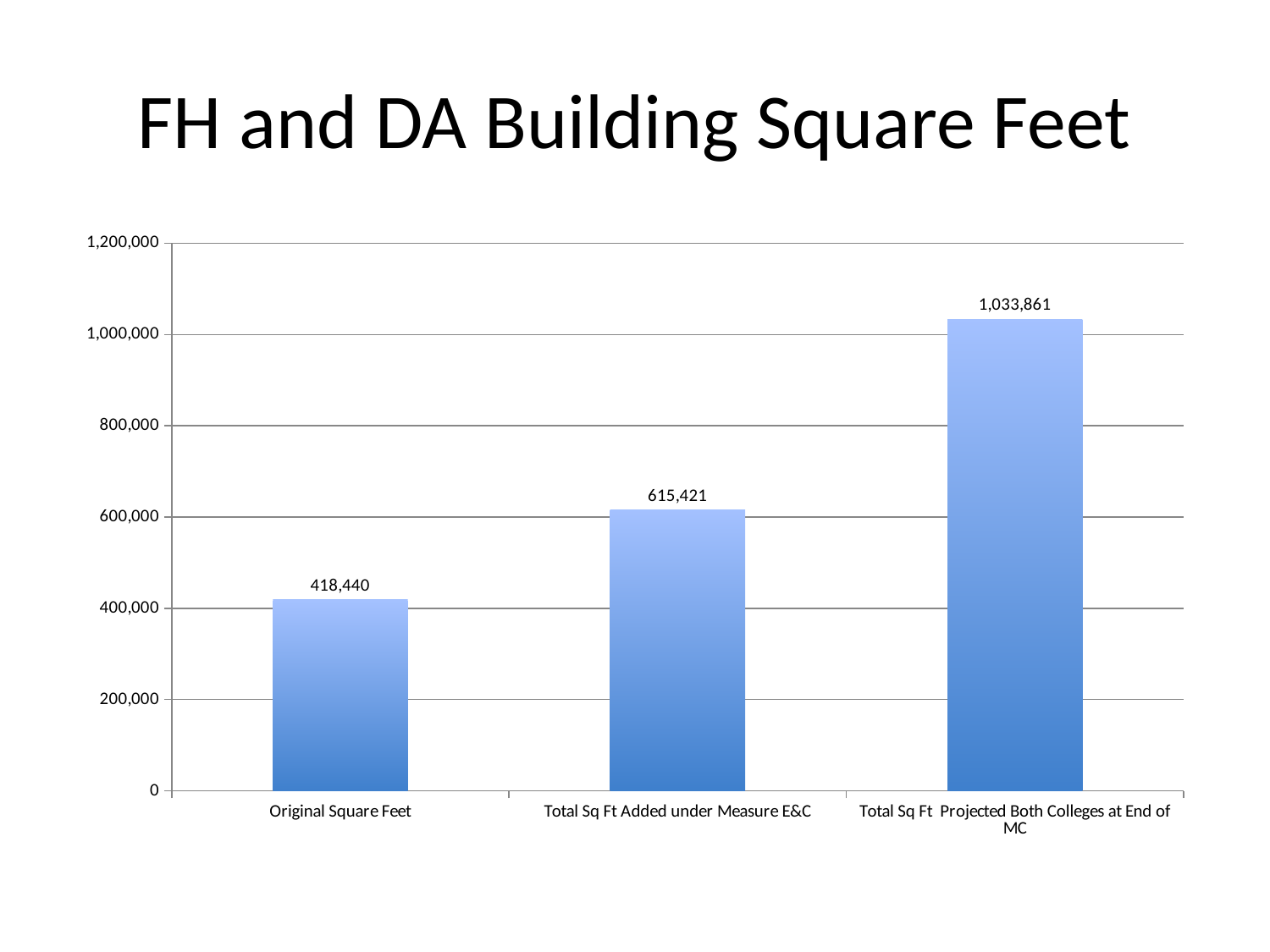
What is the value for Original Square Feet? 418,440 Which category has the lowest value? Original Square Feet What kind of chart is shown on the slide? bar chart What is the value for Total Sq Ft Added under Measure E&C? 615,421 Do the values rise or fall from left to right across the categories? rise Which category has the highest value? Total Sq Ft Projected Both Colleges at End of MC Is the value for Total Sq Ft Projected Both Colleges at End of MC greater or less than 1,000,000? greater Which is larger, Original Square Feet or Total Sq Ft Added under Measure E&C? Total Sq Ft Added under Measure E&C How many categories are shown on the chart? 3 What is the difference between Total Sq Ft Added under Measure E&C and Original Square Feet? 196,981 What is the value for Total Sq Ft Projected Both Colleges at End of MC? 1,033,861 What is the difference between Total Sq Ft Projected Both Colleges at End of MC and Total Sq Ft Added under Measure E&C? 418,440